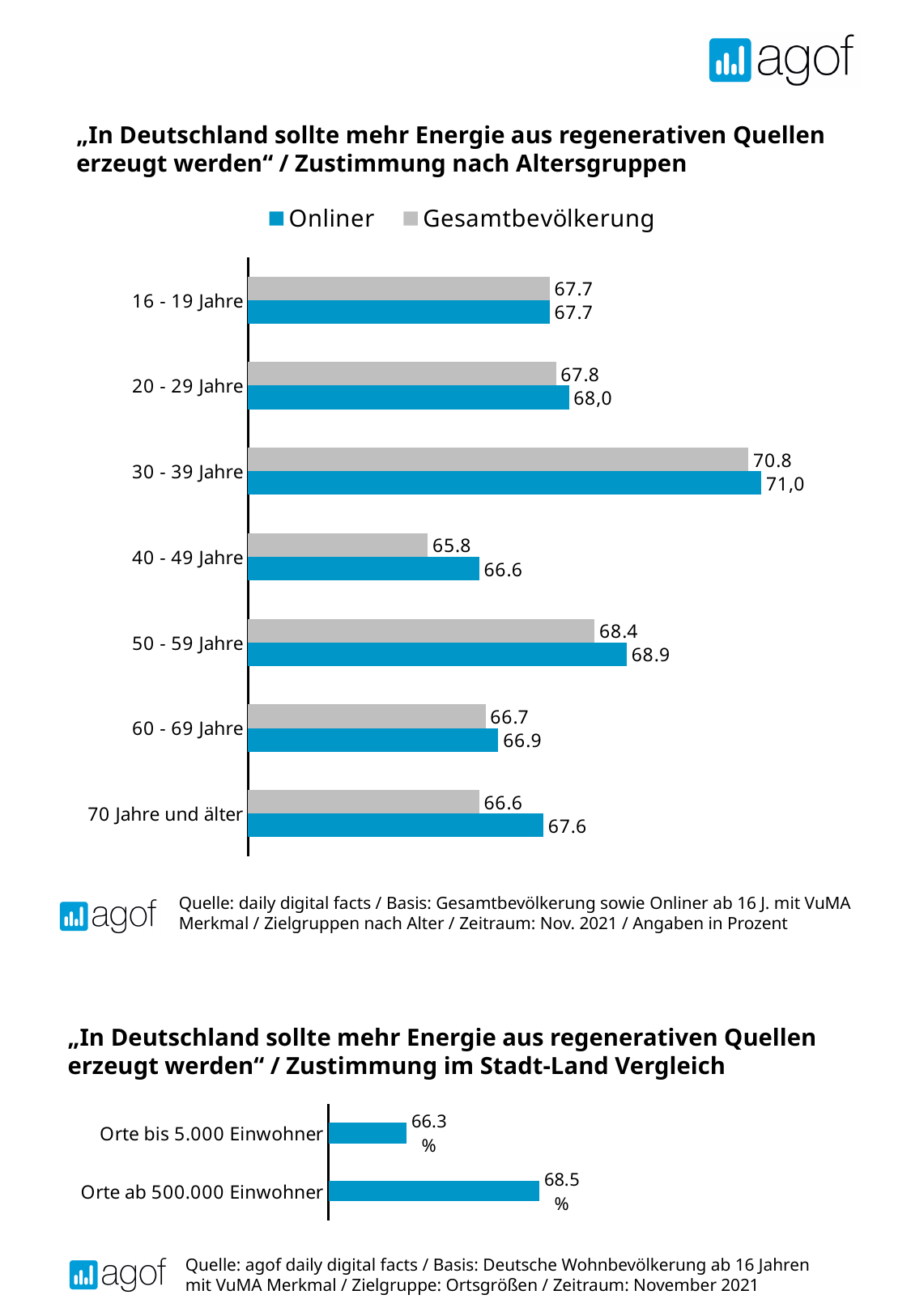
In the top chart (Zustimmung nach Altersgruppen), what is the Onliner value for 70 Jahre und älter? 67.6 In the bottom chart (Zustimmung im Stadt-Land Vergleich), which category has the higher value? Orte ab 500.000 Einwohner In the top chart (Zustimmung nach Altersgruppen), which age group has the lowest Gesamtbevölkerung value? 40 - 49 Jahre In the top chart (Zustimmung nach Altersgruppen), what is the Gesamtbevölkerung value for 40 - 49 Jahre? 65.8 In the top chart (Zustimmung nach Altersgruppen), which is larger for 50 - 59 Jahre: the Onliner value or the Gesamtbevölkerung value? Onliner How many age groups are shown in the top chart (Zustimmung nach Altersgruppen)? 7 How many series does the legend of the top chart (Zustimmung nach Altersgruppen) list? 2 In the top chart (Zustimmung nach Altersgruppen), what is the difference between the Onliner and Gesamtbevölkerung values for 70 Jahre und älter? 1.0 What kind of chart is the bottom chart (Zustimmung im Stadt-Land Vergleich)? bar chart In the top chart (Zustimmung nach Altersgruppen), what is the Onliner value for 30 - 39 Jahre? 71,0 In the top chart (Zustimmung nach Altersgruppen), which age group has the highest Onliner value? 30 - 39 Jahre In the bottom chart (Zustimmung im Stadt-Land Vergleich), what is the value for Orte ab 500.000 Einwohner? 68.5 %